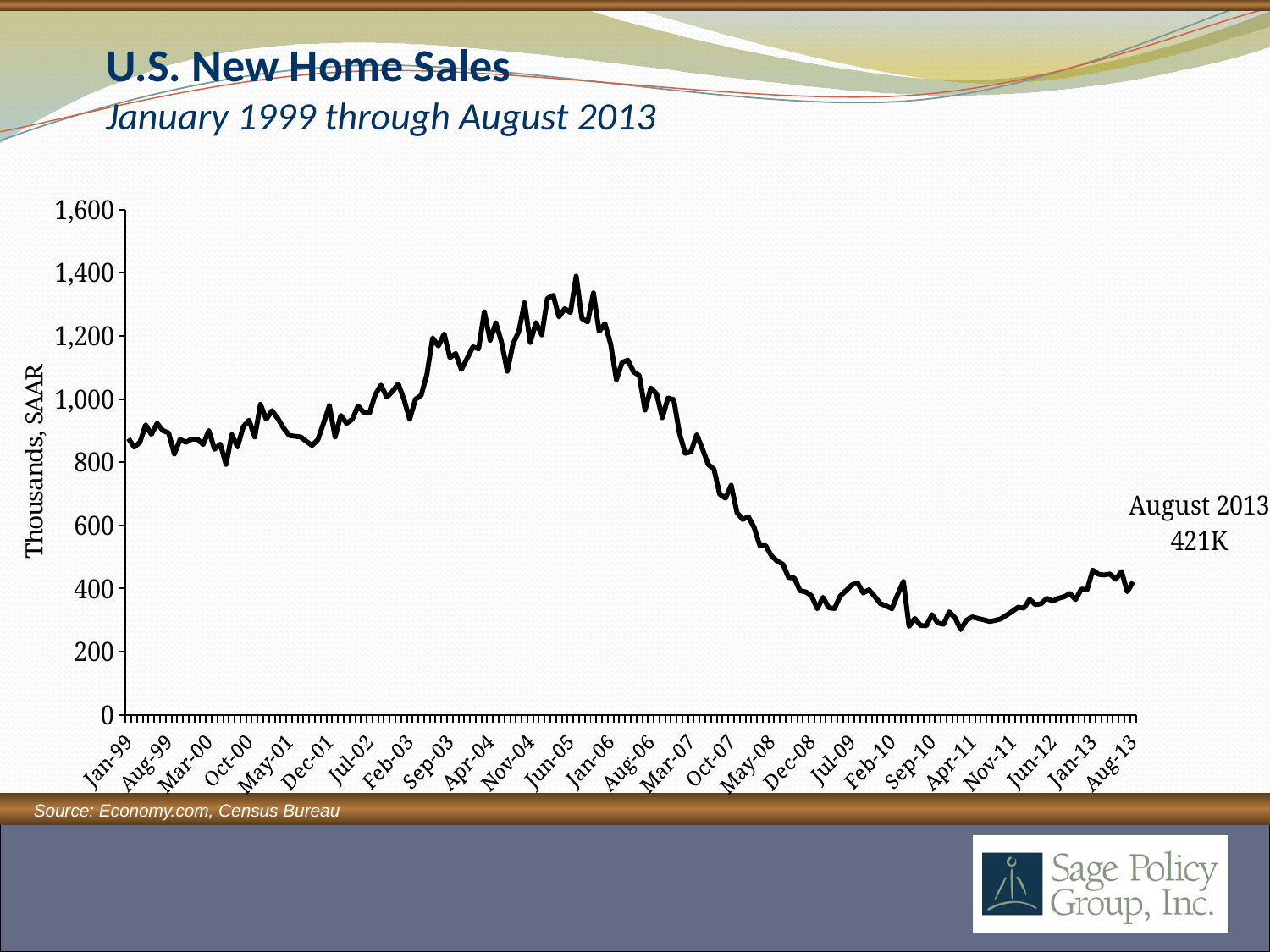
Which is larger, the value for Jun-05 or the value for Jul-09? Jun-05 What is the label on the vertical axis? Thousands, SAAR Does the line generally rise or fall between Jan-99 and Jun-05? rise In which year does the line reach its highest point? 2005 Is the value for Dec-08 greater or less than 600? less Is the value for Sep-03 greater or less than 1,000? greater Is the value for Apr-11 greater or less than 400? less Does the line rise or fall between Jun-05 and Dec-08? fall What is the value of U.S. new home sales for August 2013 as labeled on the chart? 421K What kind of chart is shown on the slide? line chart